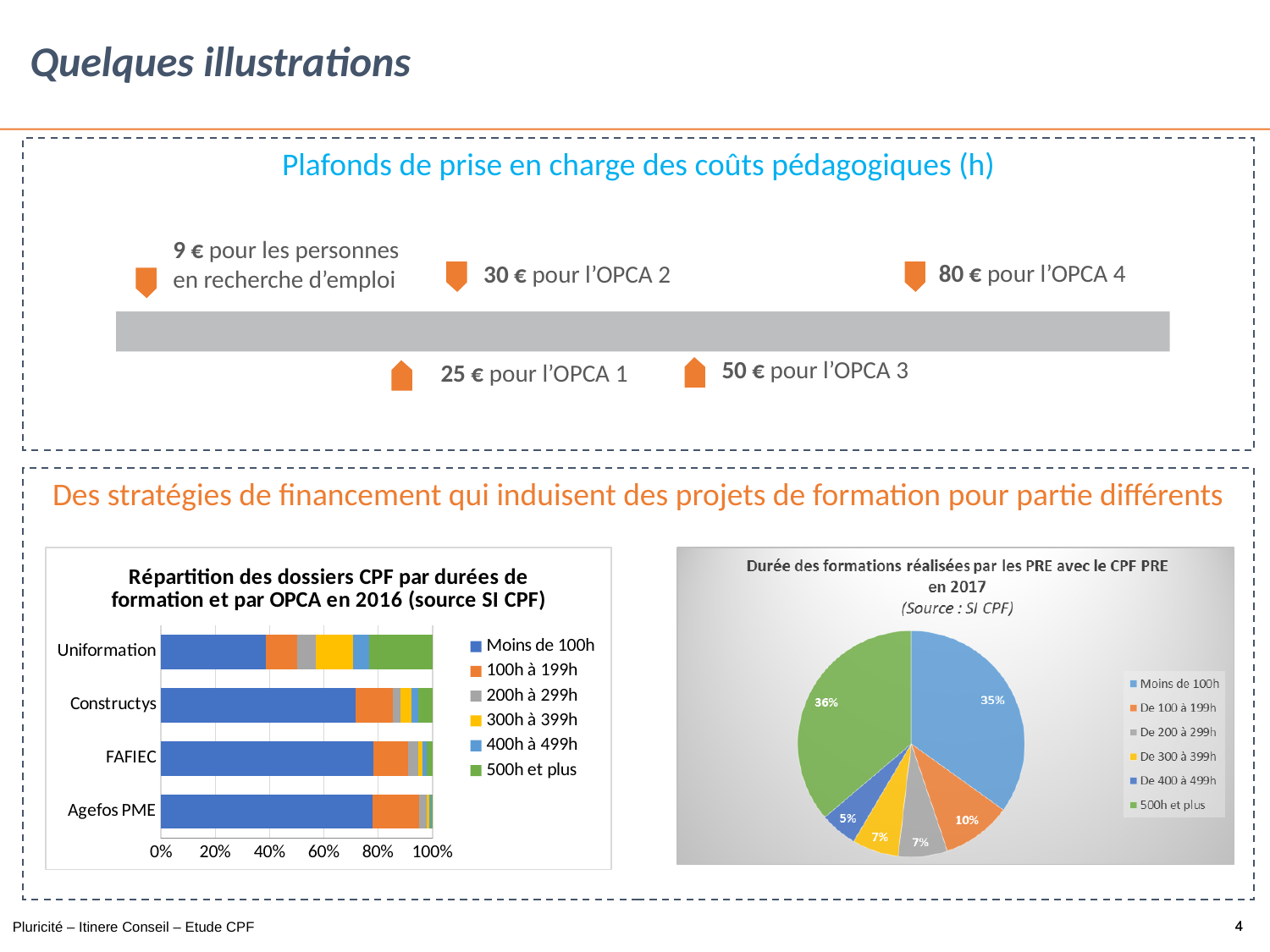
What kind of chart is 'Répartition des dossiers CPF par durées de formation et par OPCA en 2016'? Stacked bar chart In the pie chart on the right, which duration category has the smallest slice? De 400 à 499h In the pie chart on the right, which duration category has the largest slice? 500h et plus How many OPCA categories are shown in the bar chart 'Répartition des dossiers CPF par durées de formation et par OPCA en 2016'? 4 In the pie chart on the right, what is the difference in percentage points between 'Moins de 100h' and 'De 100 à 199h'? 25 percentage points How many series does the legend of the bar chart on the left list? 6 In the bar chart on the left, is the 'Moins de 100h' share for Agefos PME greater or less than 60%? greater In the pie chart on the right, what percentage is shown for 'De 400 à 499h'? 5% How many slices does the pie chart on the right have? 6 What kind of chart is the chart on the right of the slide? Pie chart In the pie chart 'Durée des formations réalisées par les PRE avec le CPF PRE en 2017', what share is shown for '500h et plus'? 36% In the pie chart on the right, what percentage is shown for 'Moins de 100h'? 35%